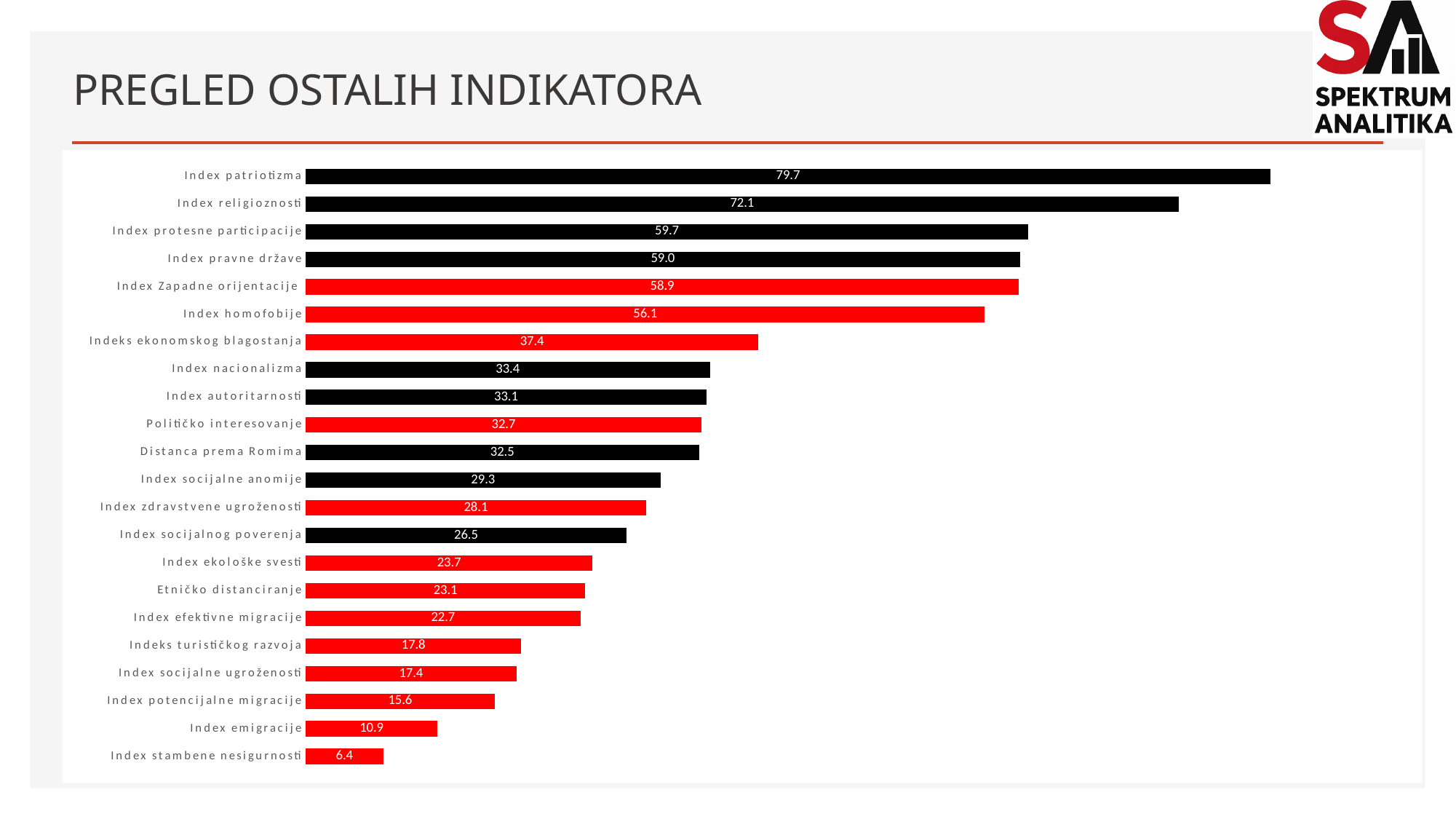
What is the value for Index patriotizma? 79.7 Which category has the lowest value? Index stambene nesigurnosti What is the value for Index homofobije? 56.1 How many categories are shown in the chart? 22 What kind of chart is shown on the slide? Bar chart Which is larger, Index nacionalizma or Index socijalnog poverenja? Index nacionalizma What is the value for Distanca prema Romima? 32.5 What is the difference between Index patriotizma and Index religioznosti? 7.6 Which category has the highest value? Index patriotizma What colour is the bar for Index Zapadne orijentacije? Red What is the difference between Index homofobije and Indeks ekonomskog blagostanja? 18.7 What is the value for Index emigracije? 10.9